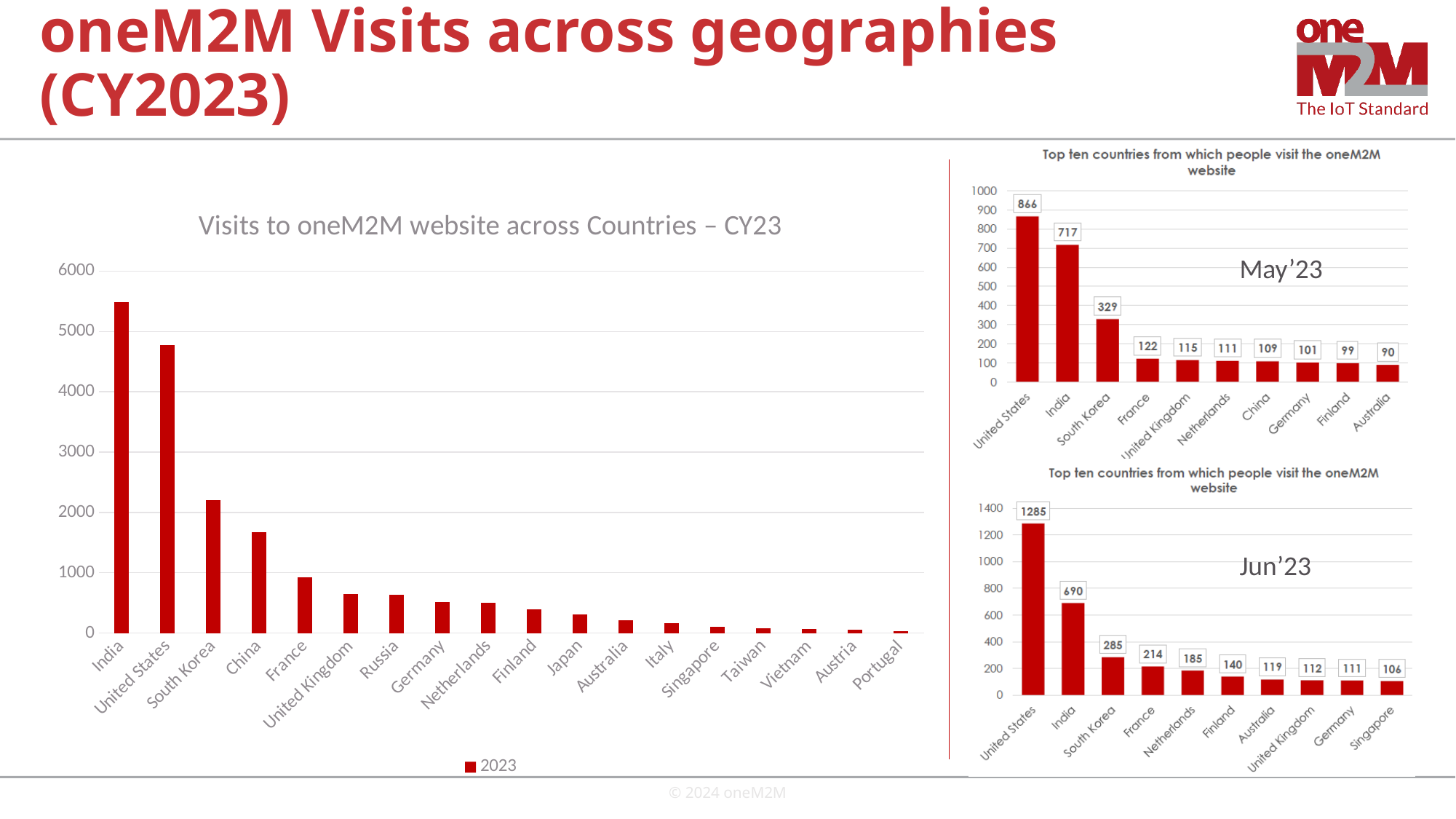
In the May'23 'Top ten countries' chart, what is the value for South Korea? 329 In the 'Visits to oneM2M website across Countries – CY23' chart, is the value for China greater or less than 2000? less In the 'Visits to oneM2M website across Countries – CY23' chart, what series name does the legend show? 2023 In the Jun'23 'Top ten countries' chart, which country has the lowest value? Singapore In the 'Visits to oneM2M website across Countries – CY23' chart, which country has the highest number of visits? India In the Jun'23 'Top ten countries' chart, what is the value for France? 214 In the 'Visits to oneM2M website across Countries – CY23' chart, is the value for India greater or less than 5000? greater In the May'23 'Top ten countries' chart, what is the value for United States? 866 What type of chart is the 'Visits to oneM2M website across Countries – CY23' chart? bar chart In the Jun'23 'Top ten countries' chart, which is larger, Netherlands or Finland? Netherlands In the 'Visits to oneM2M website across Countries – CY23' chart, how many countries are shown on the x axis? 18 In the May'23 'Top ten countries' chart, what is the difference between United States and India? 149